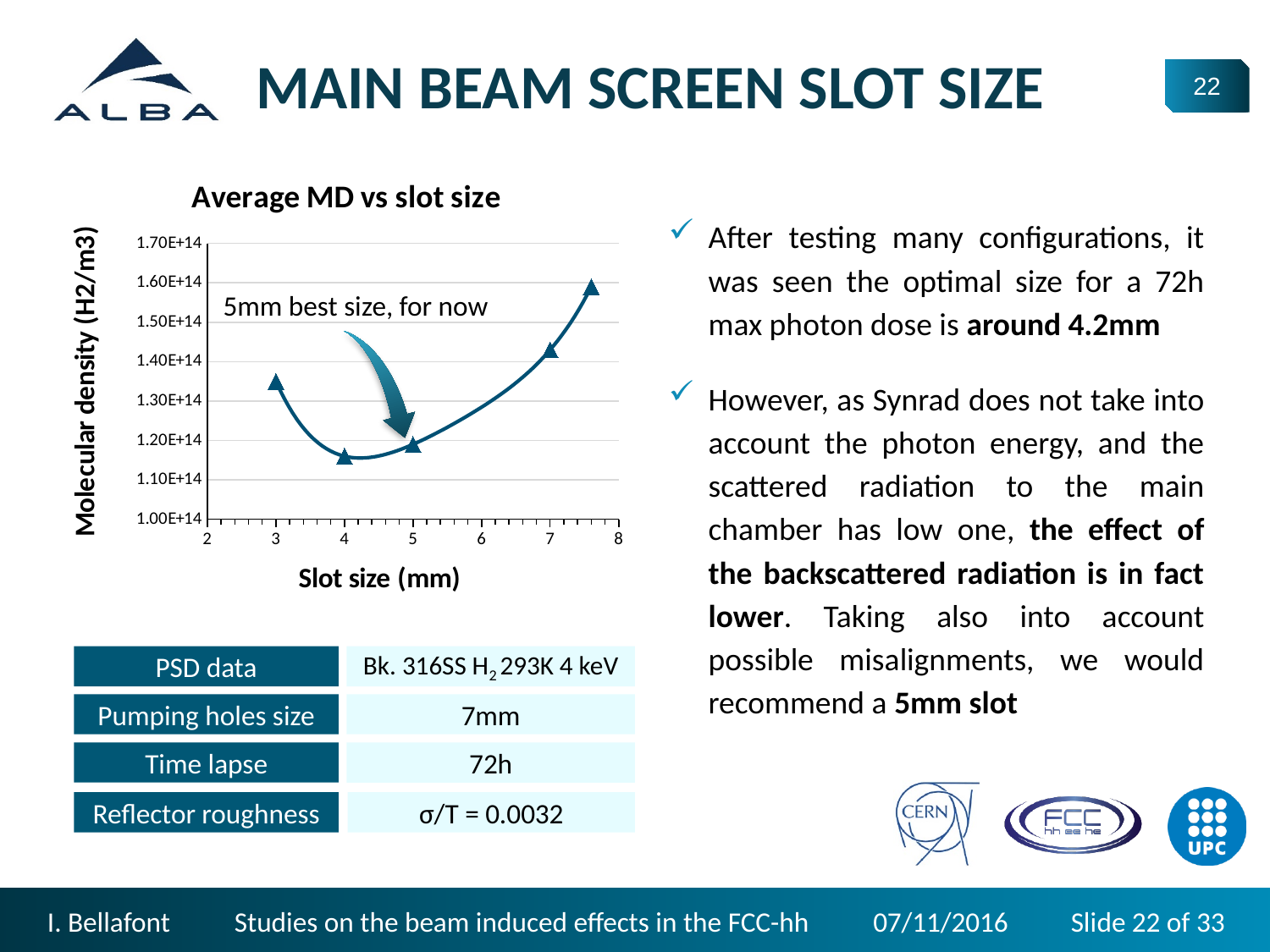
Is the molecular density at a slot size of 4 mm greater or less than 1.20E+14? less How many data points are plotted on the chart? 5 Which plotted point has the highest molecular density, the one at 3 mm or the rightmost one near 7.6 mm? the one near 7.6 mm Is the molecular density at a slot size of 3 mm greater or less than 1.30E+14? greater Is the molecular density at a slot size of 7 mm greater or less than 1.40E+14? greater Between slot sizes of 4 mm and 7 mm, does the molecular density rise or fall as slot size increases? rise At which slot size is the molecular density lowest? 4 mm Which has the higher molecular density, the point at 3 mm or the point at 5 mm? 3 mm What kind of chart is shown on the slide? line chart What is the title of the chart? Average MD vs slot size What is the label of the x axis of the chart? Slot size (mm)